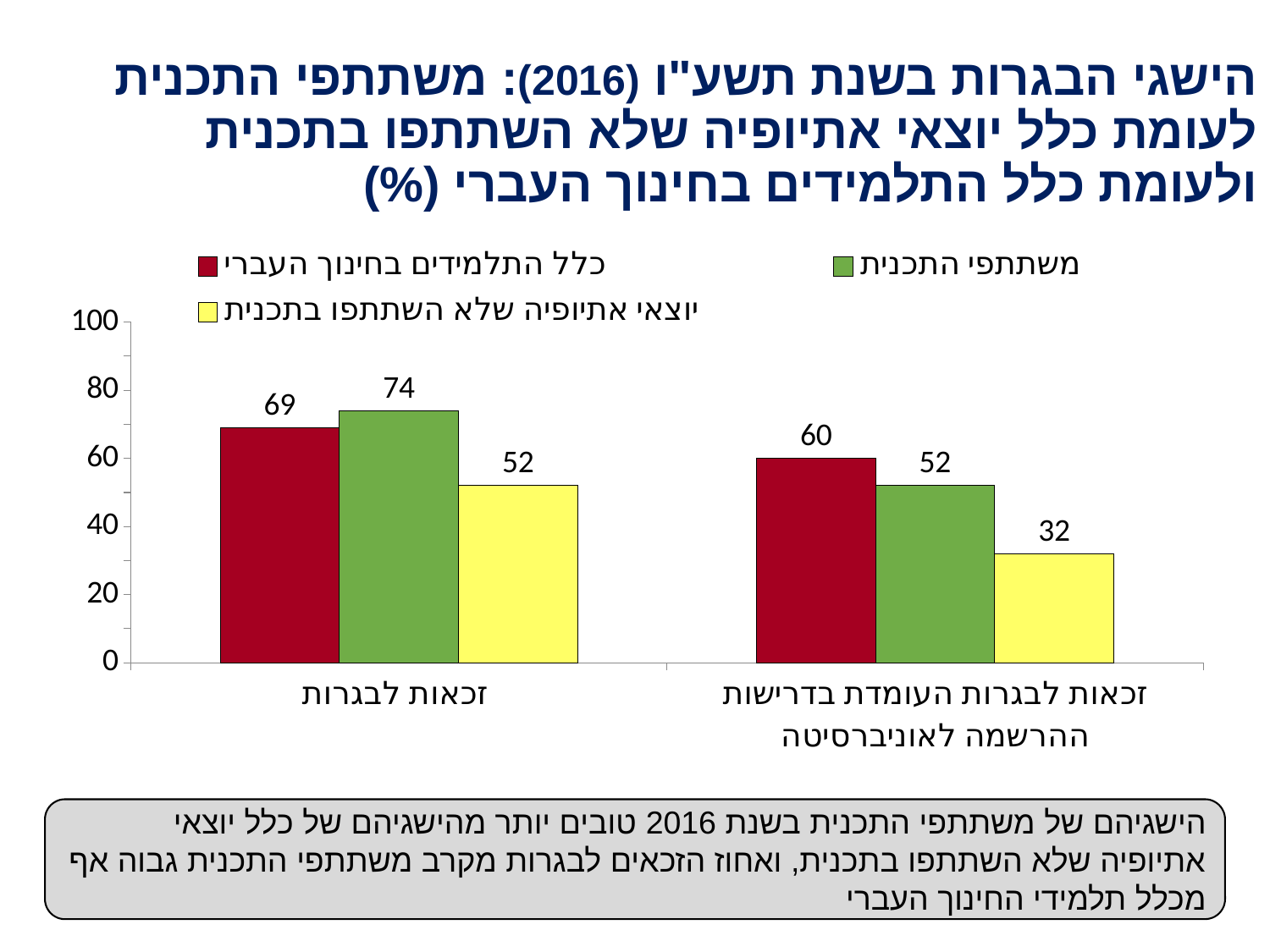
Which series has the lowest value in the זכאות לבגרות category? יוצאי אתיופיה שלא השתתפו בתכנית Is the value for יוצאי אתיופיה שלא השתתפו בתכנית in the זכאות לבגרות העומדת בדרישות ההרשמה לאוניברסיטה category greater or less than 40? less What is the value for משתתפי התכנית in the זכאות לבגרות category? 74 How many series does the legend list? 3 What is the value for כלל התלמידים בחינוך העברי in the זכאות לבגרות category? 69 How many categories are shown on the x axis? 2 What is the difference between משתתפי התכנית and יוצאי אתיופיה שלא השתתפו בתכנית in the זכאות לבגרות category? 22 In the זכאות לבגרות category, which is larger: משתתפי התכנית or כלל התלמידים בחינוך העברי? משתתפי התכנית What is the value for יוצאי אתיופיה שלא השתתפו בתכנית in the זכאות לבגרות העומדת בדרישות ההרשמה לאוניברסיטה category? 32 What is the difference between כלל התלמידים בחינוך העברי and משתתפי התכנית in the זכאות לבגרות העומדת בדרישות ההרשמה לאוניברסיטה category? 8 Which series has the highest value in the זכאות לבגרות העומדת בדרישות ההרשמה לאוניברסיטה category? כלל התלמידים בחינוך העברי What kind of chart is shown on the slide? bar chart